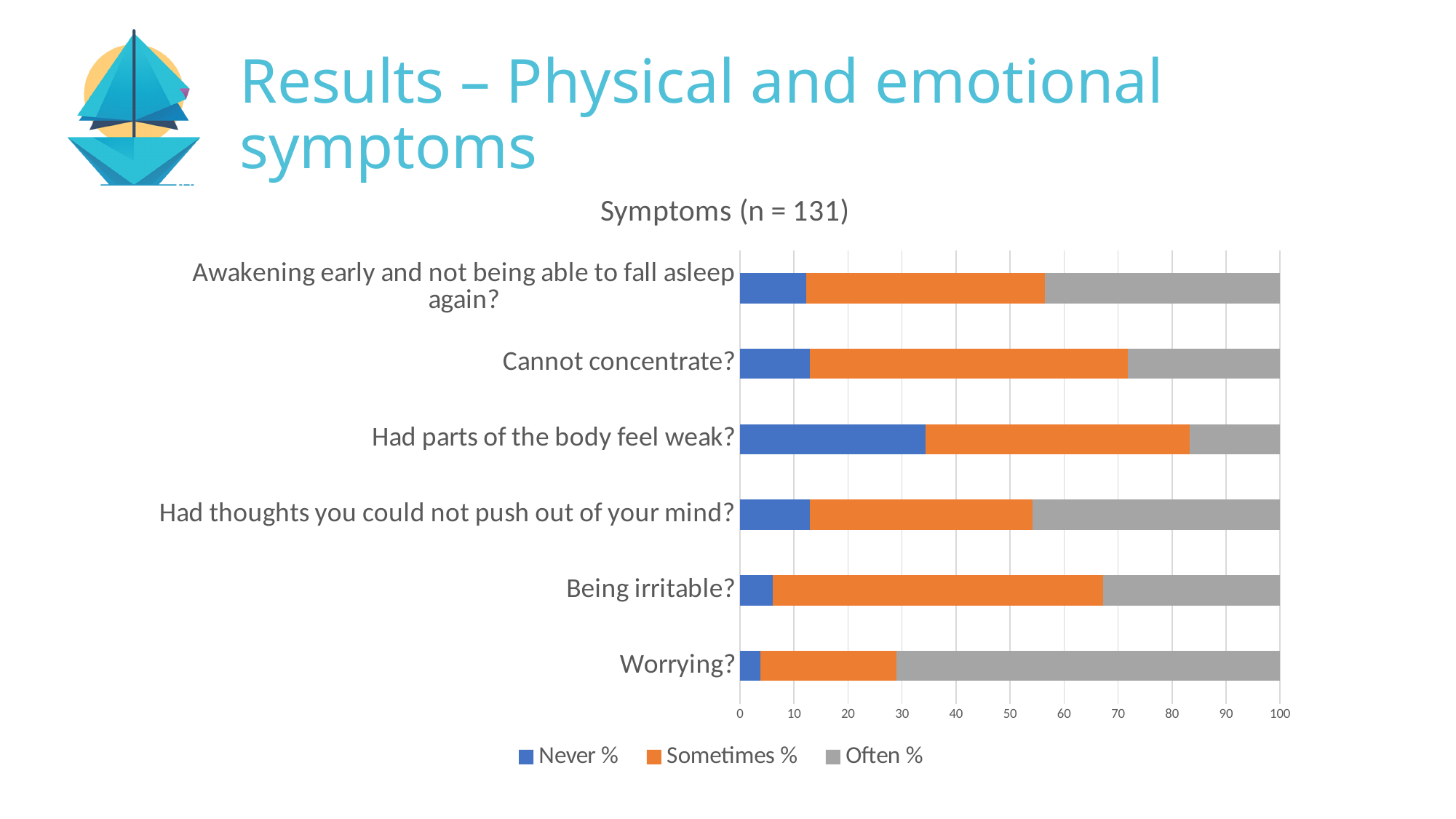
Which is larger: the Often % for 'Worrying?' or the Often % for 'Cannot concentrate?'? Worrying? How many series does the chart legend list? 3 Is the Never % value for 'Had parts of the body feel weak?' greater or less than 30? greater Is the Never % value for 'Worrying?' greater or less than 10? less How many symptom categories are plotted in the chart? 6 What is the title of the chart? Symptoms (n = 131) Which symptom has the highest Never % value? Had parts of the body feel weak? What kind of chart is shown on the slide? Stacked bar chart Which series is shown in orange in the chart? Sometimes % What is the total of the stacked bar for 'Being irritable?'? 100 Which symptom has the lowest Often % value? Had parts of the body feel weak? Which symptom has the highest Often % value? Worrying?